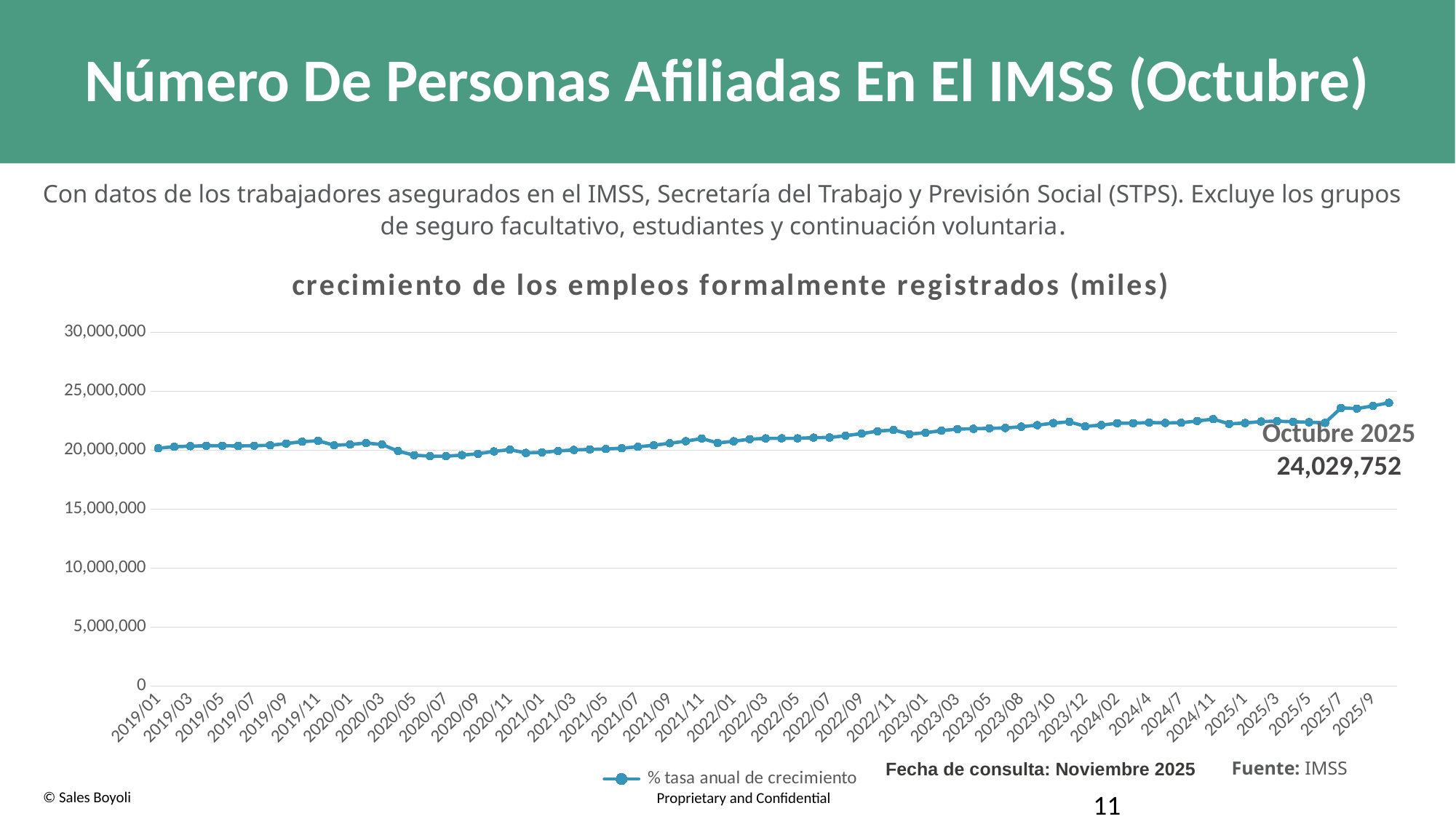
In which year does the lowest point of the line occur? 2020 Overall, do the values rise or fall from 2019/01 to 2025/9 along the x axis? rise What is the value labelled for Octubre 2025 on the chart? 24,029,752 Is the value for 2020/07 greater or less than 25,000,000? less Is the value for 2019/01 greater or less than 25,000,000? less What kind of chart is shown on the slide? line chart What is the title of the chart? crecimiento de los empleos formalmente registrados (miles) What is the name of the series shown in the chart legend? % tasa anual de crecimiento How many series does the chart legend list? 1 Which point on the chart has the highest value? Octubre 2025 Which is larger, the value for 2019/01 or the value for 2025/9? 2025/9 Is the value for 2025/9 greater or less than 20,000,000? greater